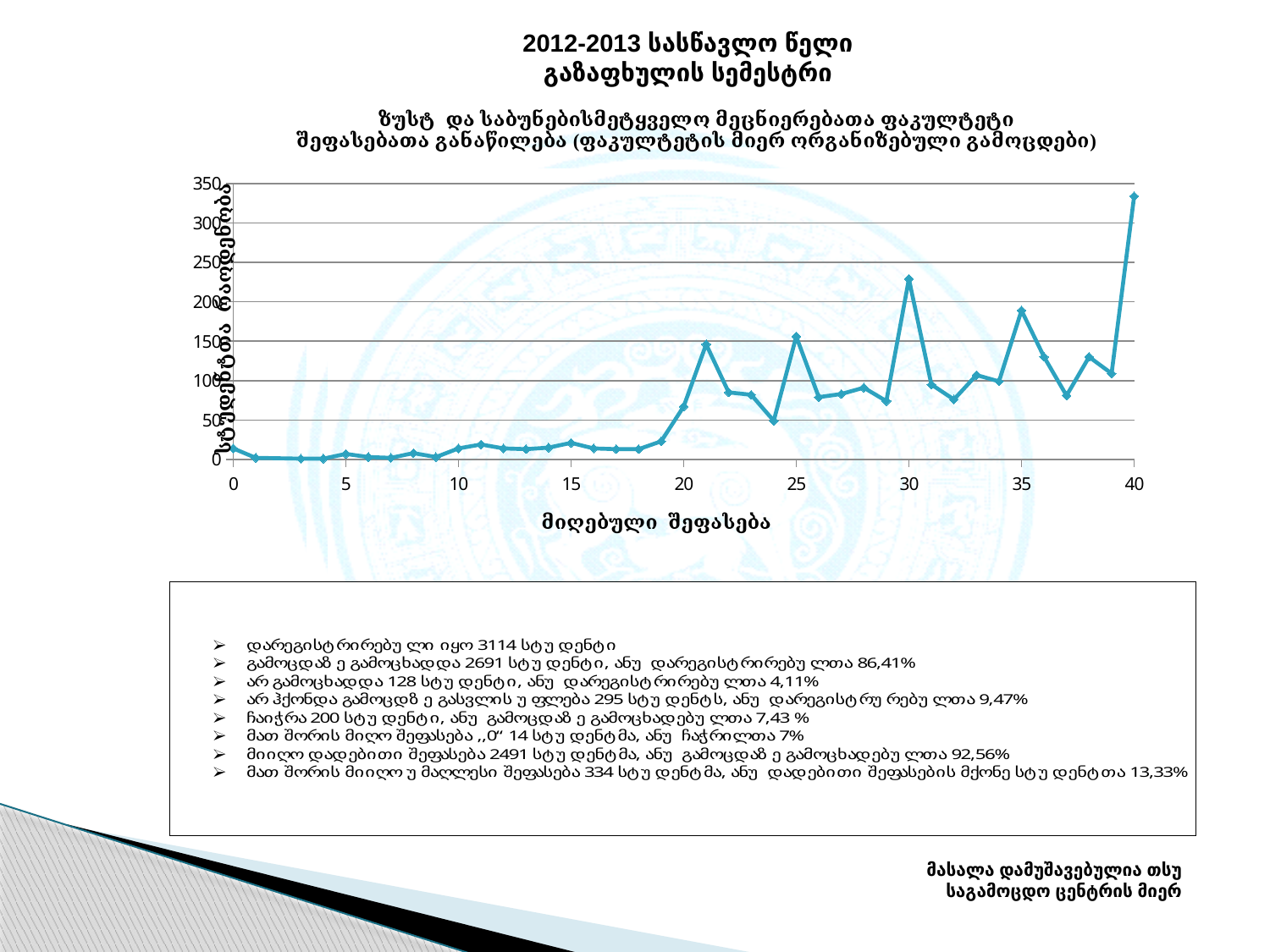
Which has more students, score 30 or score 25? score 30 Is the value for score 40 greater or less than 300? greater Is the value for score 24 greater or less than 100? less Which has more students, score 35 or score 32? score 35 Is the value for score 30 greater or less than 200? greater Overall, do the values rise or fall as the score increases along the x axis? rise Which score on the x axis has the highest number of students? 40 What is the highest tick value shown on the y axis? 350 What kind of chart is shown on the slide? line chart